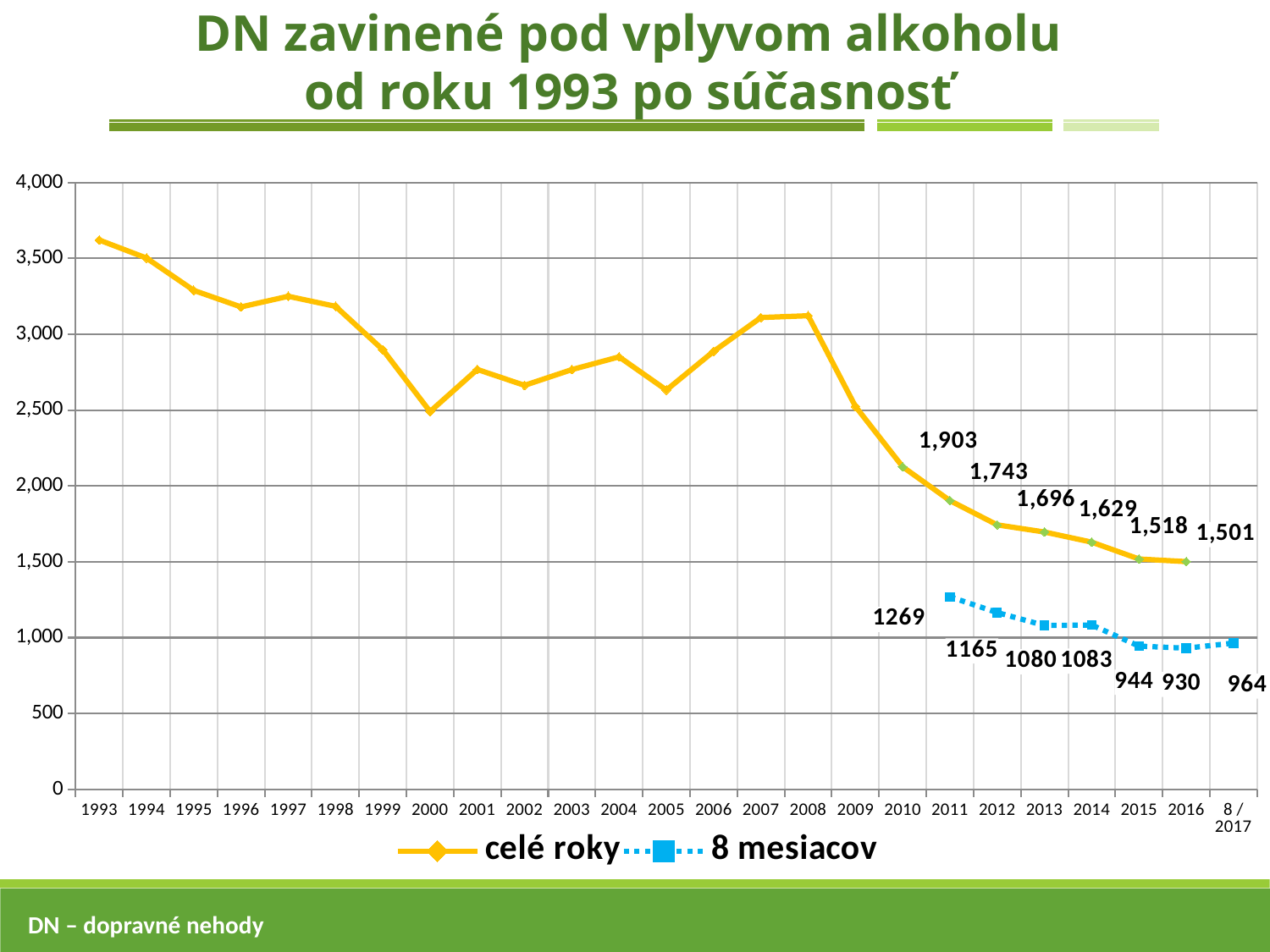
Is the 'celé roky' value for 2000 greater or less than 3,000? less What is the difference between the '8 mesiacov' values for 2011 and 2012? 104 In which year does the '8 mesiacov' series have its lowest value? 2016 What is the difference between the 'celé roky' values for 2011 and 2016? 402 What is the value of the 'celé roky' series for 2016? 1,501 What is the value of the '8 mesiacov' series for 2015? 944 What kind of chart is shown on the slide? line chart What is the value of the '8 mesiacov' series for 8/2017? 964 Is the 'celé roky' value for 1993 greater or less than 3,500? greater How many series does the legend list? 2 What is the value of the 'celé roky' series for 2011? 1,903 Which is larger for the '8 mesiacov' series: the value for 2013 or for 2014? 2014